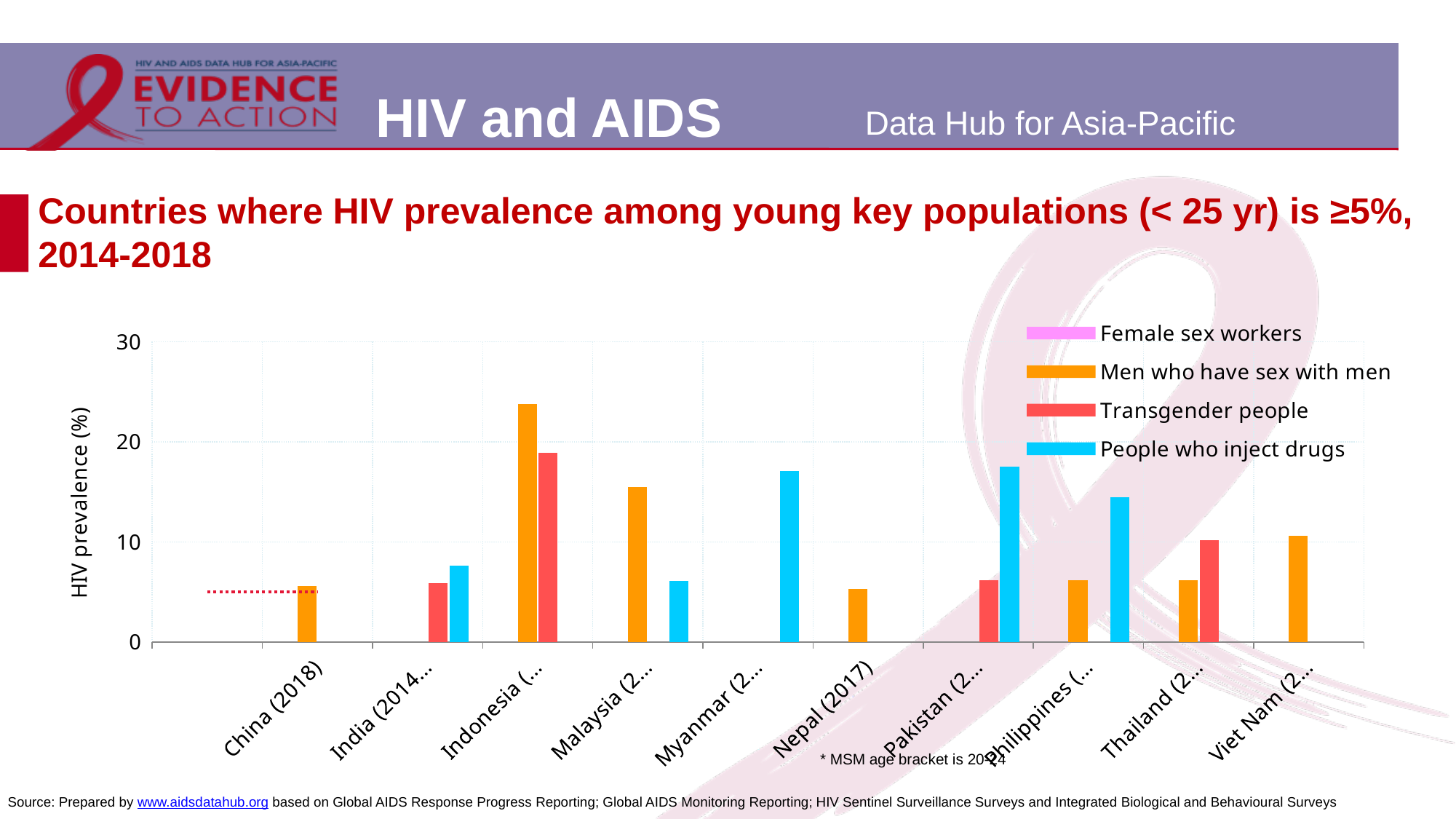
Which country has the tallest bar in the chart? Indonesia How many countries are shown along the x axis of the chart? 10 What kind of chart is shown on the slide? bar chart Which is larger: the Men who have sex with men value for Indonesia or for Malaysia? Indonesia How many series does the chart legend list? 4 Is the value for People who inject drugs in Pakistan greater or less than 10? greater Is the value for Men who have sex with men in Nepal (2017) greater or less than 10? less Is the value for Men who have sex with men in Indonesia greater or less than 20? greater Which is larger: the People who inject drugs value for Myanmar or for Malaysia? Myanmar What is the label of the y axis of the chart? HIV prevalence (%)